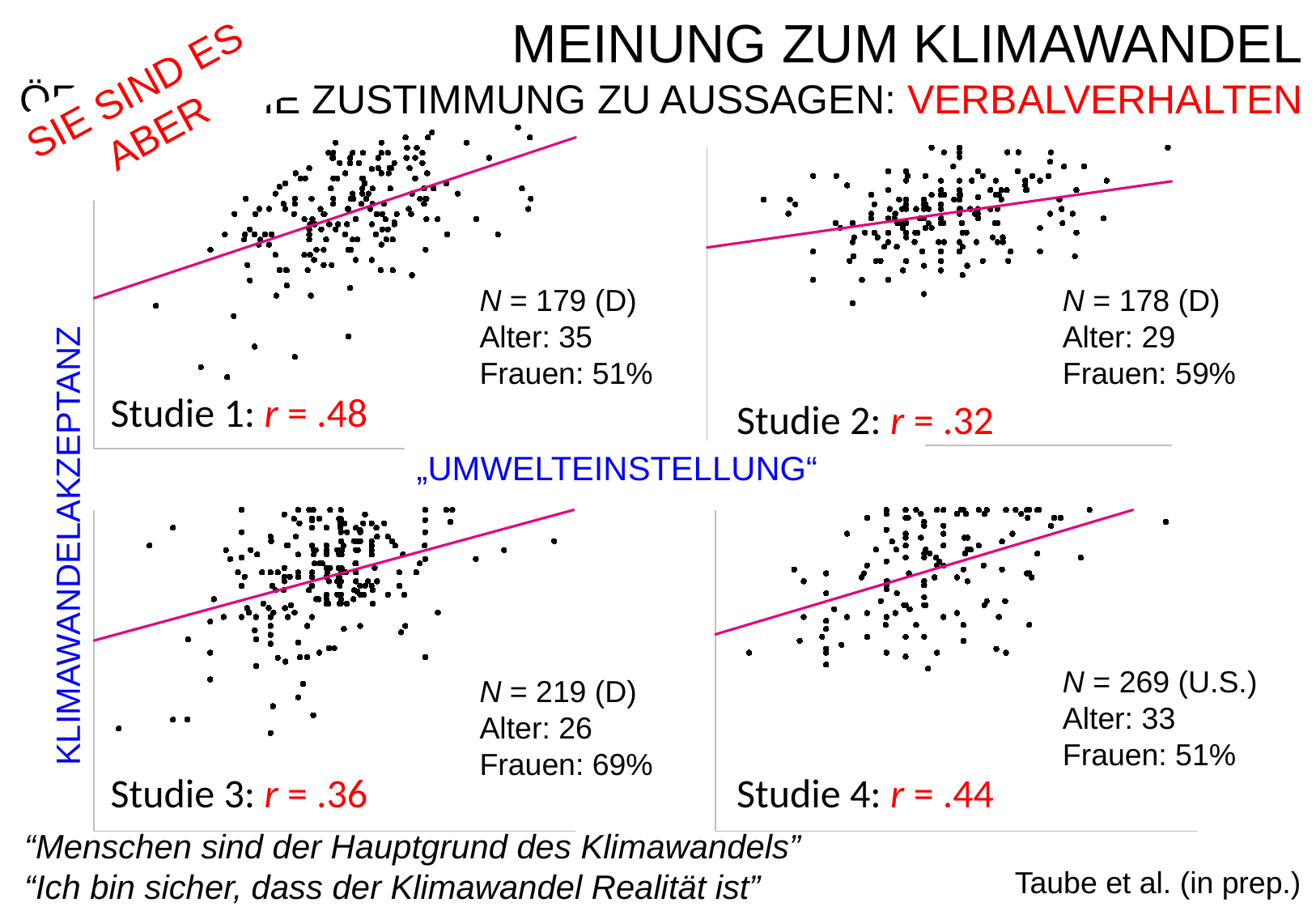
What sample size N is reported for the Studie 4 chart? 269 Which of the four studies has the lowest correlation coefficient r? Studie 2 What kind of chart is used for each of the four studies? Scatter plot What is the label on the vertical axis shared by the charts? KLIMAWANDELAKZEPTANZ What is the difference between the r values of Studie 1 and Studie 2? .16 What sample size N is reported for the Studie 3 chart? 219 In the Studie 1 chart, does the fitted line rise or fall from left to right? Rises Which study has the larger correlation coefficient, Studie 3 or Studie 4? Studie 4 What is the correlation coefficient r shown for Studie 1? r = .48 Which of the four studies has the highest correlation coefficient r? Studie 1 What is the correlation coefficient r shown for Studie 2? r = .32 How many scatter plots are shown on the slide? 4